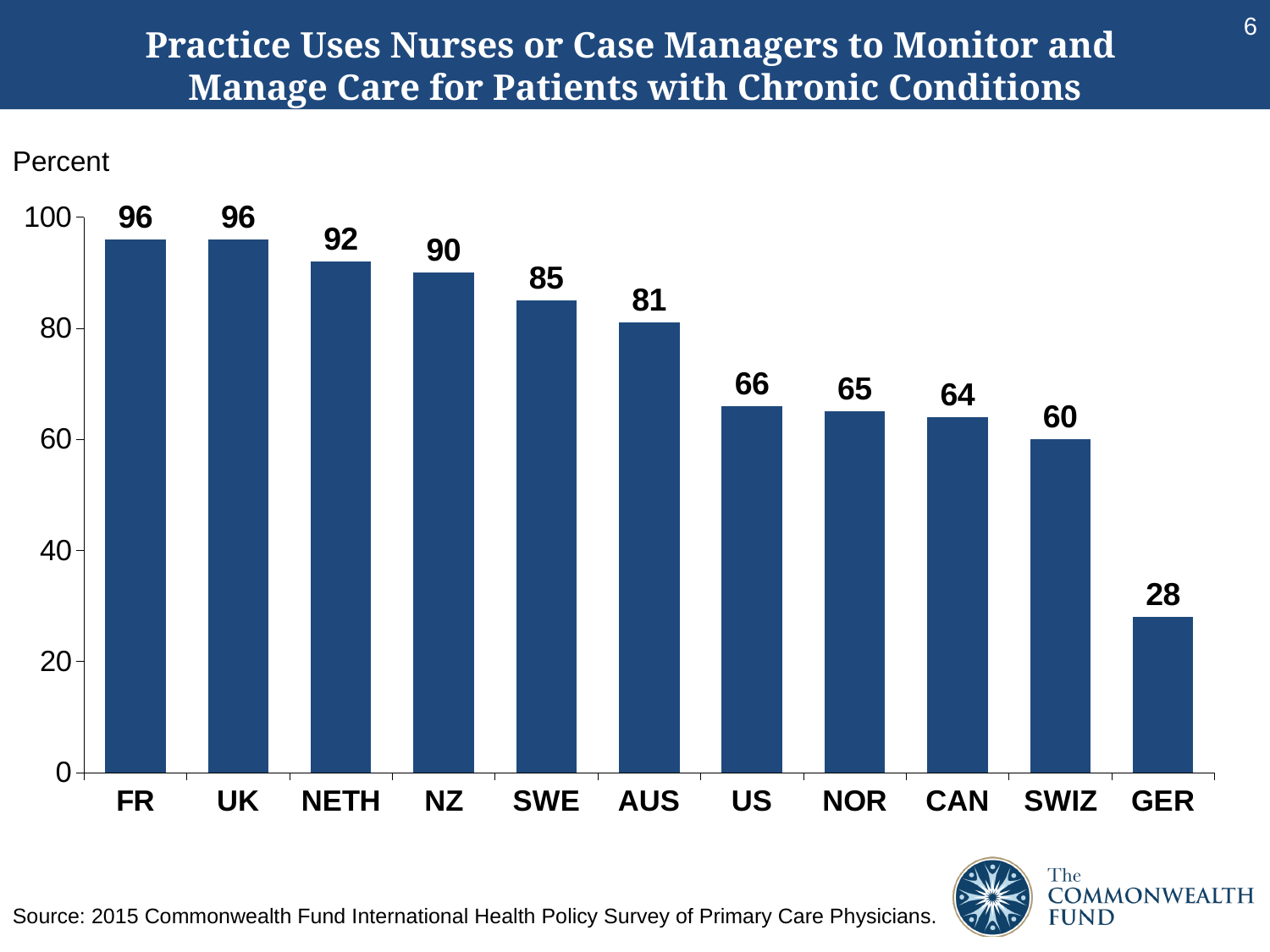
What is the value for SWIZ? 60 Is the value for CAN greater or less than 80? less What is the difference between the values for NZ and GER? 62 Do the values rise or fall from left to right across the chart? fall Which country has the lowest value? GER What kind of chart is shown on the slide? bar chart What is the value for US? 66 Which is larger, the value for NOR or the value for SWIZ? NOR What is the label on the vertical axis of the chart? Percent How many countries are shown on the chart? 11 What is the value for NETH? 92 What is the difference between the values for SWE and AUS? 4